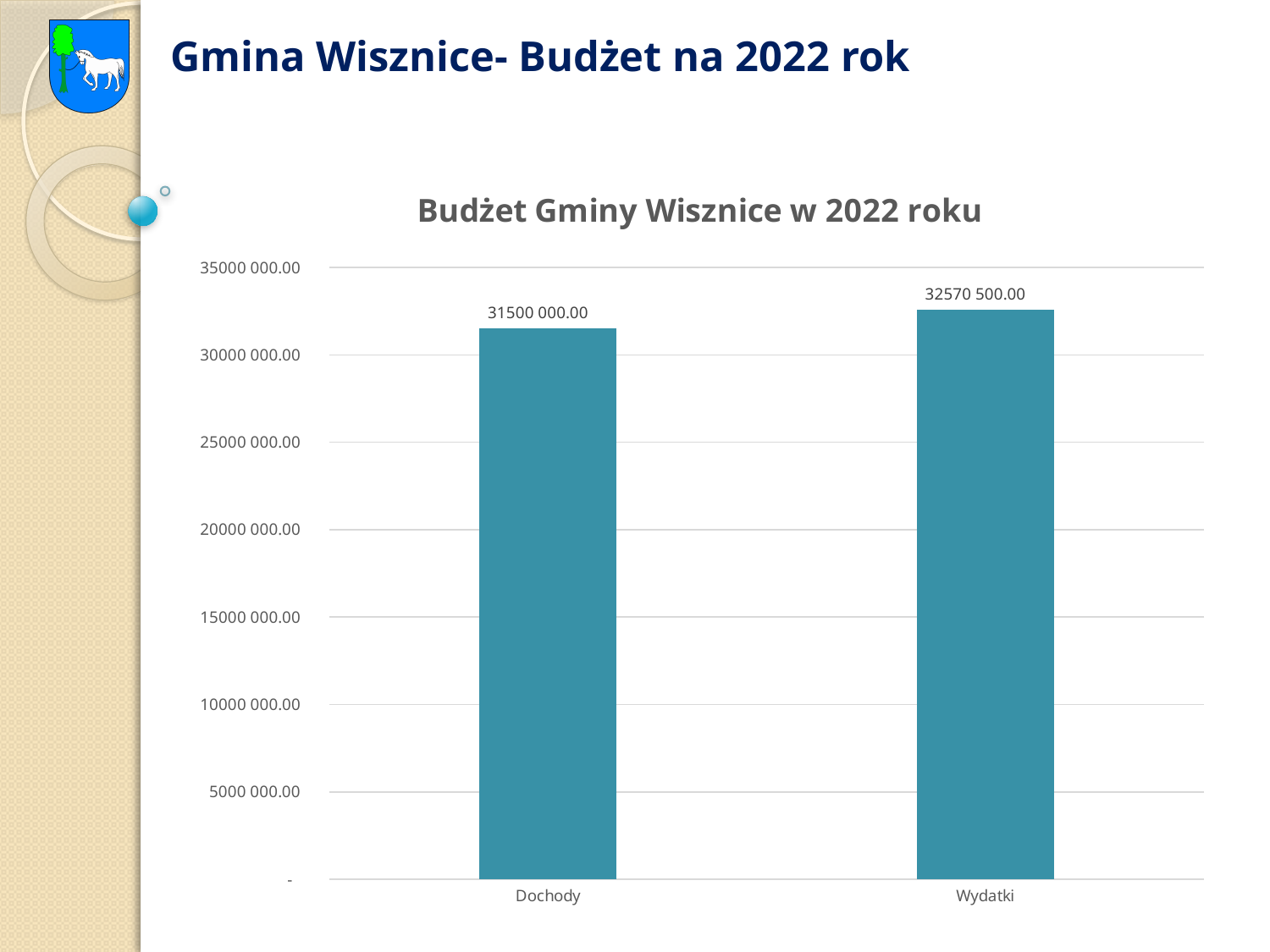
What is the value for Dochody? 31500 000.00 Which is larger, Dochody or Wydatki? Wydatki Is the value for Wydatki greater or less than 35000 000.00? less What is the title of the chart? Budżet Gminy Wisznice w 2022 roku What is the total of Dochody and Wydatki? 64070 500.00 What kind of chart is shown on the slide? bar chart How many categories are shown in the chart? 2 Which category has the lowest value? Dochody Is the value for Dochody greater or less than 30000 000.00? greater What is the difference between Wydatki and Dochody? 1070 500.00 What is the value for Wydatki? 32570 500.00 Which category has the highest value? Wydatki